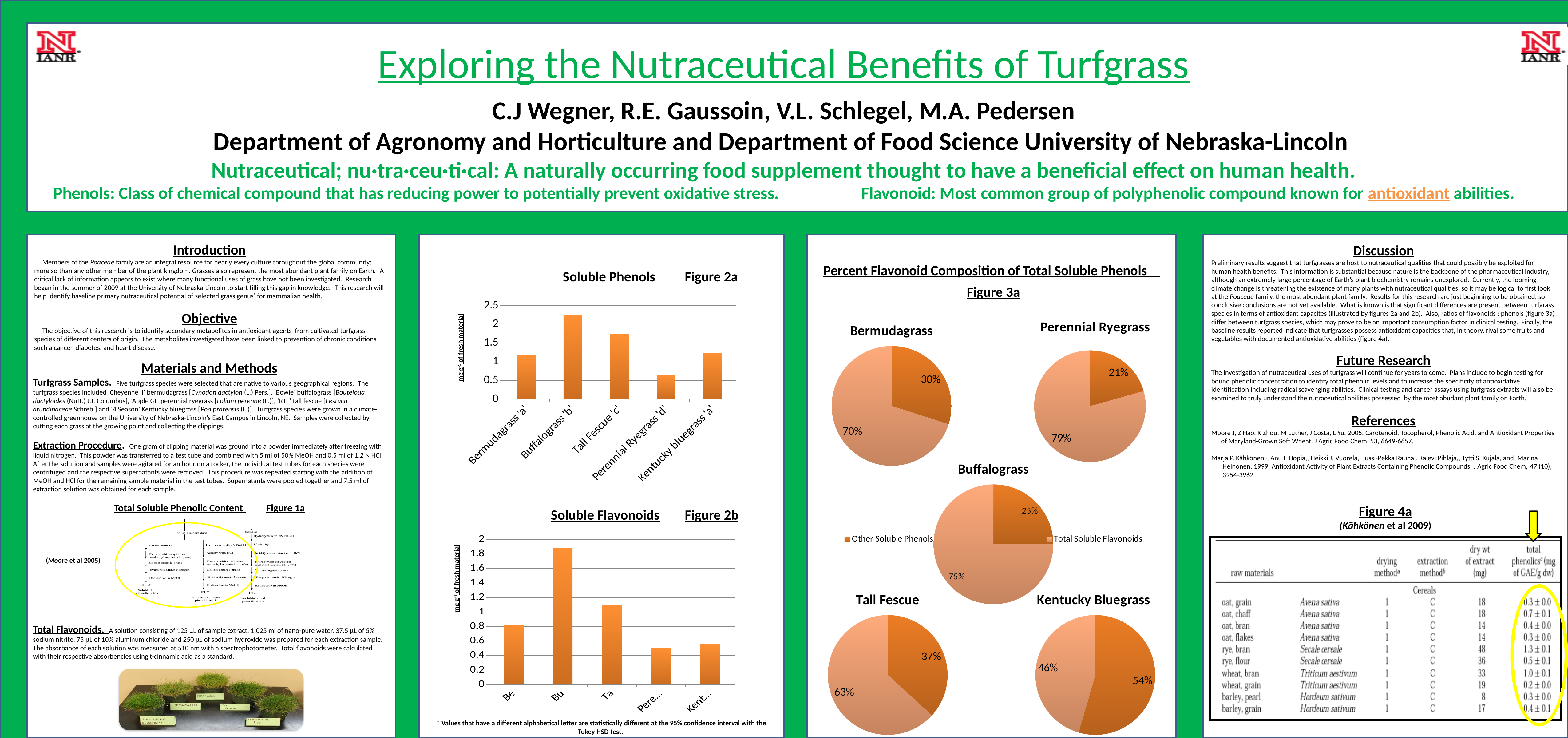
In Figure 2a (Soluble Phenols), which category has the lowest value? Perennial Ryegrass 'd' In Figure 3a, what is the difference between the two slices of the Tall Fescue pie? 26% In Figure 2a (Soluble Phenols), is the value for Perennial Ryegrass 'd' greater or less than 1? less In Figure 2a (Soluble Phenols), is the value for Buffalograss 'b' greater or less than 2? greater What kind of chart is Figure 2a (Soluble Phenols)? bar chart In Figure 2b (Soluble Flavonoids), which is larger, the value for Ta or the value for Be? Ta In Figure 2b (Soluble Flavonoids), is the value for Be greater or less than 1? less In Figure 2a (Soluble Phenols), which category has the highest value? Buffalograss 'b' How many categories are plotted in Figure 2a (Soluble Phenols)? 5 In Figure 3a, what percentage is the smaller slice of the Perennial Ryegrass pie? 21% In Figure 2b (Soluble Flavonoids), which category has the highest value? Bu In Figure 3a, what percentage is the larger slice of the Bermudagrass pie? 70%